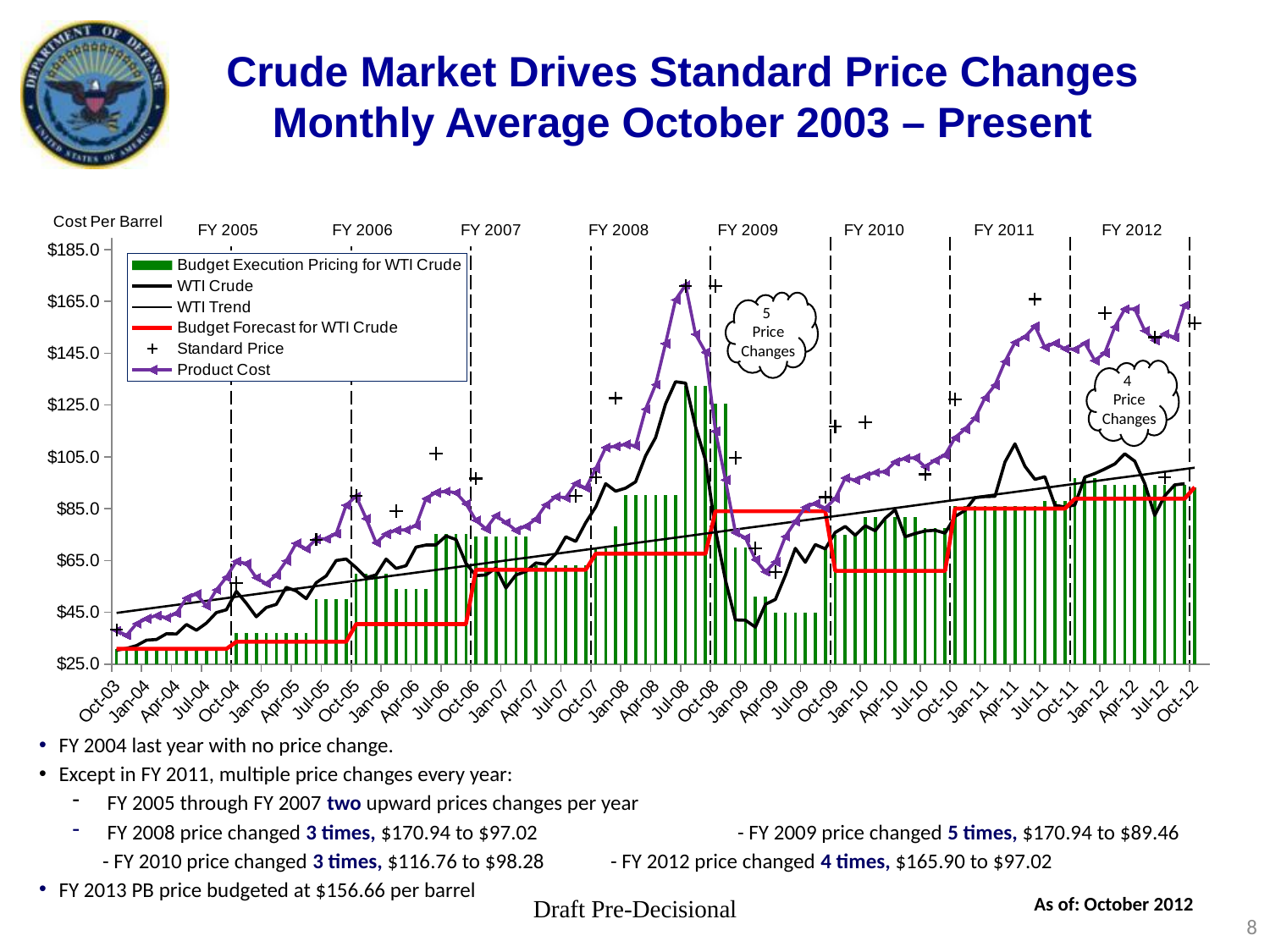
Does the WTI Trend line rise or fall from Oct-03 to Oct-12? Rise How many series does the chart legend list? 6 Is the Product Cost value at Oct-03 greater or less than $45? less What is the label on the vertical axis of the chart? Cost Per Barrel Is the WTI Crude value at Oct-03 greater or less than $45? less What kind of chart is shown on the slide? A combination bar and line chart Which is larger, the WTI Crude value at Jul-08 or at Jan-09? Jul-08 Is the Budget Forecast for WTI Crude at Jan-09 greater or less than $65? greater Which series in the legend is drawn as green bars? Budget Execution Pricing for WTI Crude